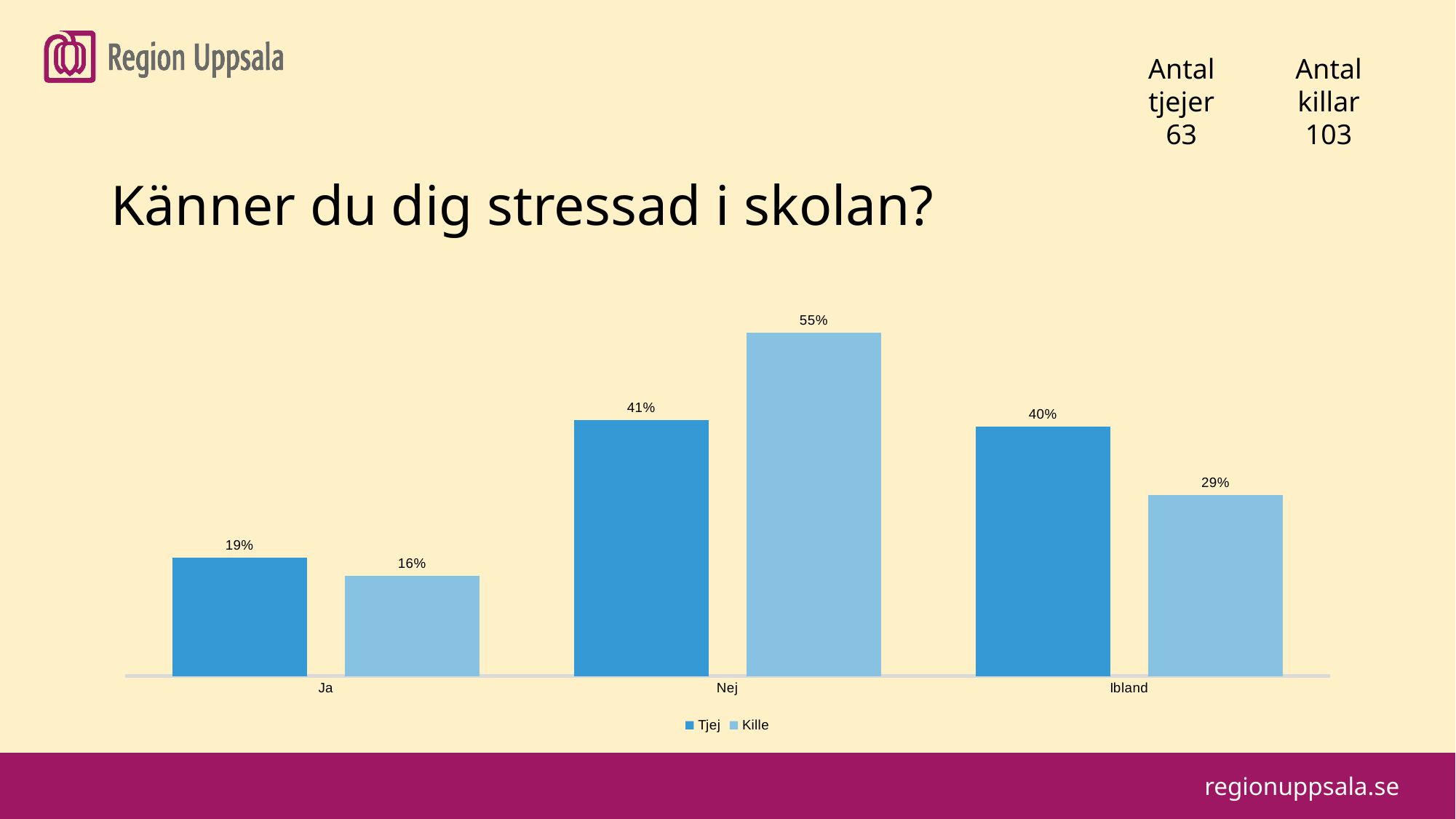
What is the value for Tjej in the Ibland category? 40% Which category has the highest value for the Kille series? Nej What is the value for Kille in the Ja category? 16% How many series does the legend list? 2 In the Ibland category, which series has the larger value, Tjej or Kille? Tjej What is the difference between the Kille and Tjej values in the Nej category? 14% What kind of chart is shown on the slide? Bar chart What is the value for Kille in the Nej category? 55% How many categories are shown on the x axis? 3 What are the two series named in the legend? Tjej and Kille What is the value for Tjej in the Ja category? 19% Which category has the lowest value for the Tjej series? Ja